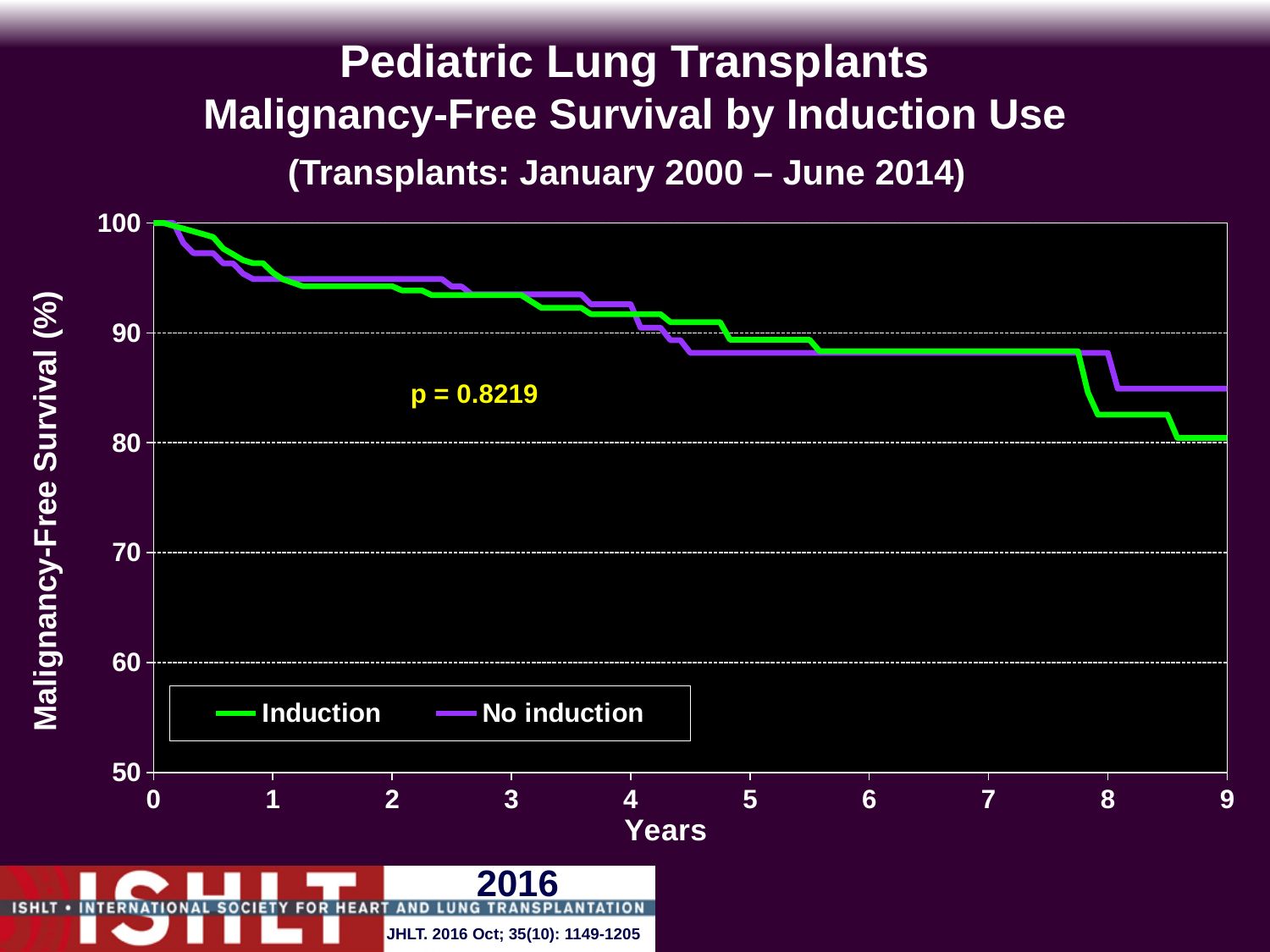
Which two series are shown in the legend? Induction and No induction At 9 years, which series has the higher malignancy-free survival, Induction or No induction? No induction What p-value is printed on the chart? p = 0.8219 Is the value for No induction at 9 years greater or less than 80? greater Is the value for Induction at 2 years greater or less than 90? greater Do the malignancy-free survival values rise or fall as years increase? fall How many series does the legend list? 2 Is the value for Induction at 5 years greater or less than 80? greater What kind of chart is shown on the slide? line chart What is the label of the x axis? Years